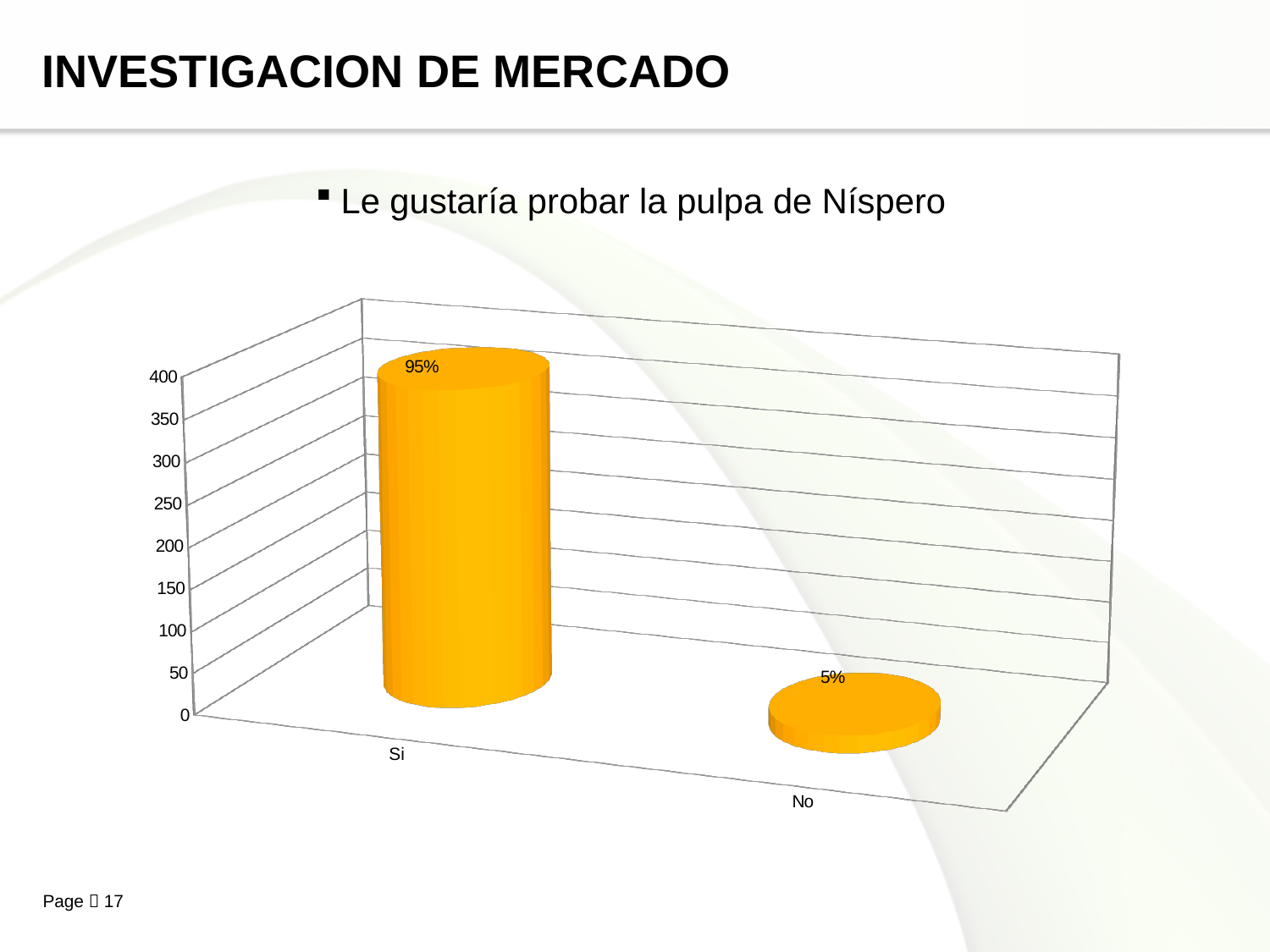
What is the highest value shown on the vertical axis? 400 Is the bar for "No" greater or less than 50 on the vertical axis? less Which is larger, the value for "Si" or the value for "No"? Si Which category has the highest value? Si What is the data label shown for the "Si" bar? 95% What question does the chart on the slide relate to, according to the bullet text above it? Le gustaría probar la pulpa de Níspero What is the data label shown for the "No" bar? 5% Which category has the lowest value? No What is the difference between the labelled values for "Si" and "No"? 90% How many categories are shown on the chart? 2 Is the bar for "Si" greater or less than 200 on the vertical axis? greater What kind of chart is shown on the slide? Bar chart